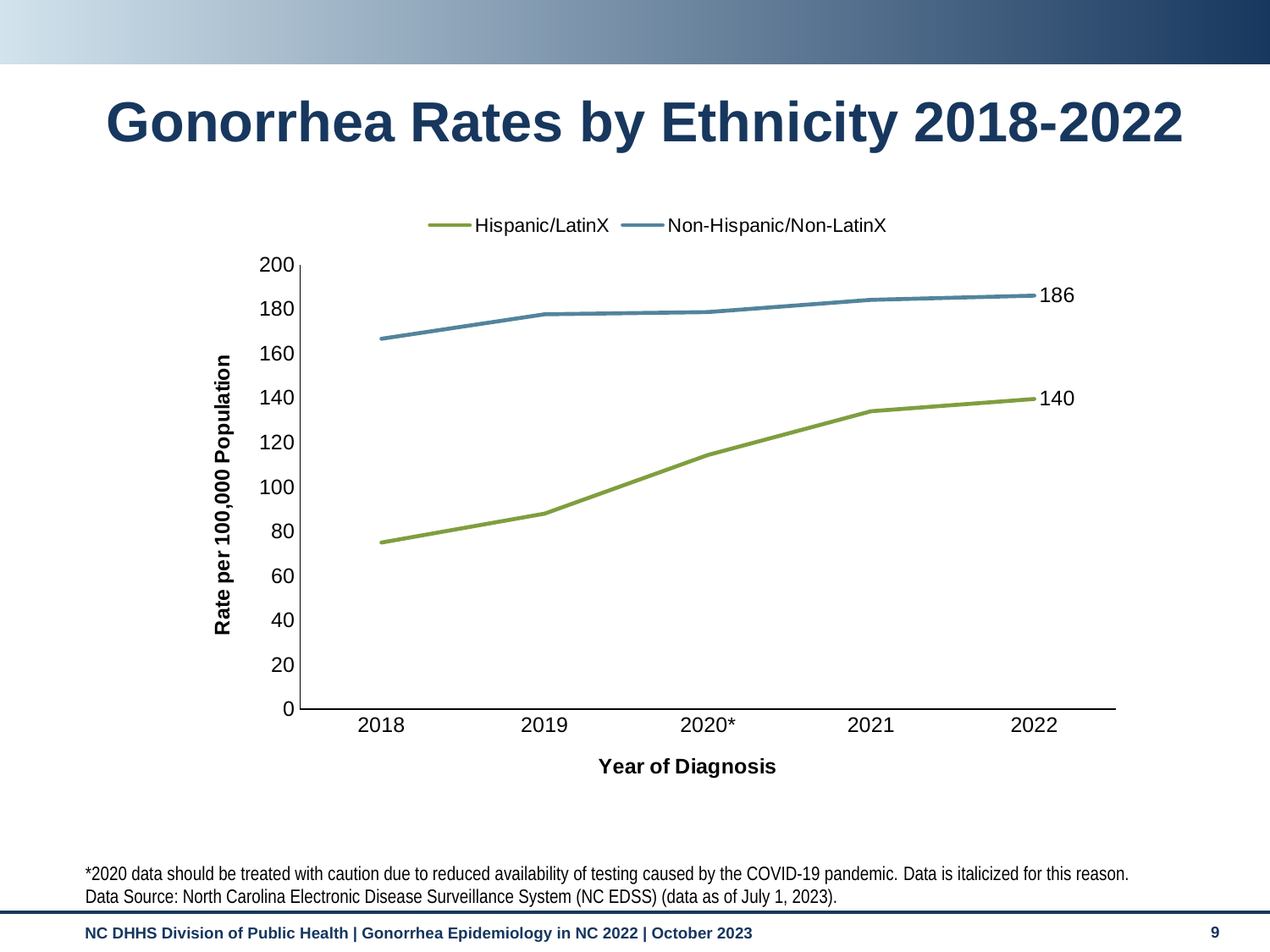
What is the gonorrhea rate for Non-Hispanic/Non-LatinX in 2022? 186 What is the label on the y axis of the chart? Rate per 100,000 Population What kind of chart is shown on the slide? Line chart Is the value for Hispanic/LatinX in 2018 greater or less than 100? less What is the difference between the Non-Hispanic/Non-LatinX and Hispanic/LatinX rates in 2022? 46 How many years are shown on the x axis of the chart? 5 Which group has the higher gonorrhea rate in 2022, Hispanic/LatinX or Non-Hispanic/Non-LatinX? Non-Hispanic/Non-LatinX Does the Hispanic/LatinX rate rise or fall from 2018 to 2022? Rise Is the value for Hispanic/LatinX in 2020* greater or less than 100? greater How many series does the legend list? 2 What is the gonorrhea rate for Hispanic/LatinX in 2022? 140 Is the value for Non-Hispanic/Non-LatinX in 2018 greater or less than 160? greater